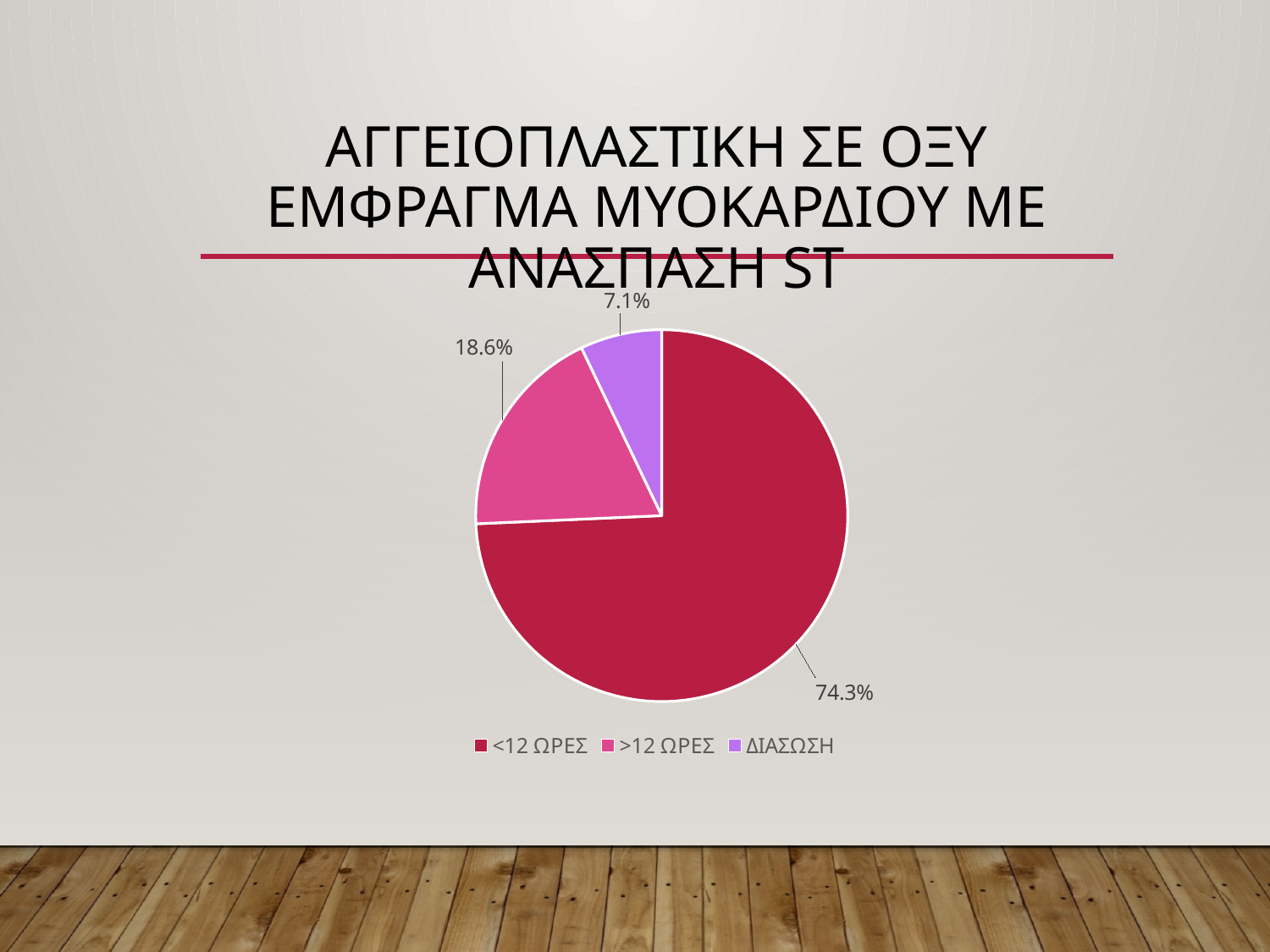
What percentage is shown for the <12 ΩΡΕΣ slice? 74.3% What colour is the ΔΙΑΣΩΣΗ slice? purple What percentage is shown for the >12 ΩΡΕΣ slice? 18.6% How many slices does the pie chart have? 3 What percentage is shown for the ΔΙΑΣΩΣΗ slice? 7.1% What is the difference in percentage points between the >12 ΩΡΕΣ slice and the ΔΙΑΣΩΣΗ slice? 11.5 How many entries does the legend list? 3 Which slice is larger, >12 ΩΡΕΣ or ΔΙΑΣΩΣΗ? >12 ΩΡΕΣ Which category has the smallest slice of the pie? ΔΙΑΣΩΣΗ What is the difference in percentage points between the <12 ΩΡΕΣ slice and the >12 ΩΡΕΣ slice? 55.7 Which category has the largest slice of the pie? <12 ΩΡΕΣ What type of chart is shown on the slide? pie chart